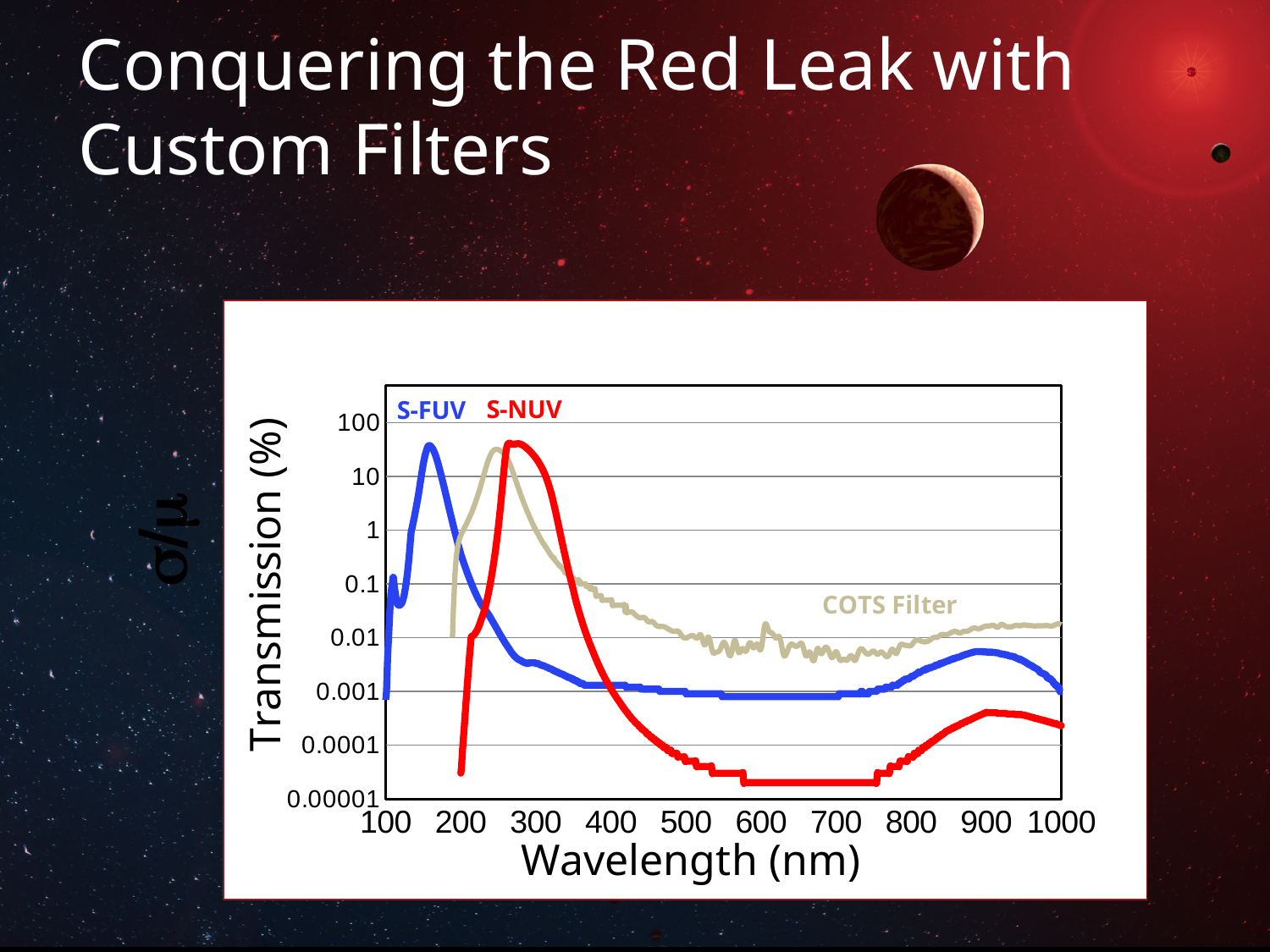
Is the transmission of S-NUV at 600 nm greater or less than 0.0001? less At 600 nm, which has the higher transmission, S-FUV or S-NUV? S-FUV How many series are labelled on the chart? 3 What colour is the S-NUV line on the chart? red What is the label of the y axis of the chart? Transmission (%) Is the peak transmission of S-FUV greater or less than 10? greater Does the S-NUV transmission rise or fall between 300 nm and 600 nm? fall Is the transmission of the COTS Filter at 600 nm greater or less than 0.001? greater What kind of chart is shown on the slide? line chart Which series has the lowest transmission at 700 nm? S-NUV Which series has the highest transmission at 900 nm? COTS Filter